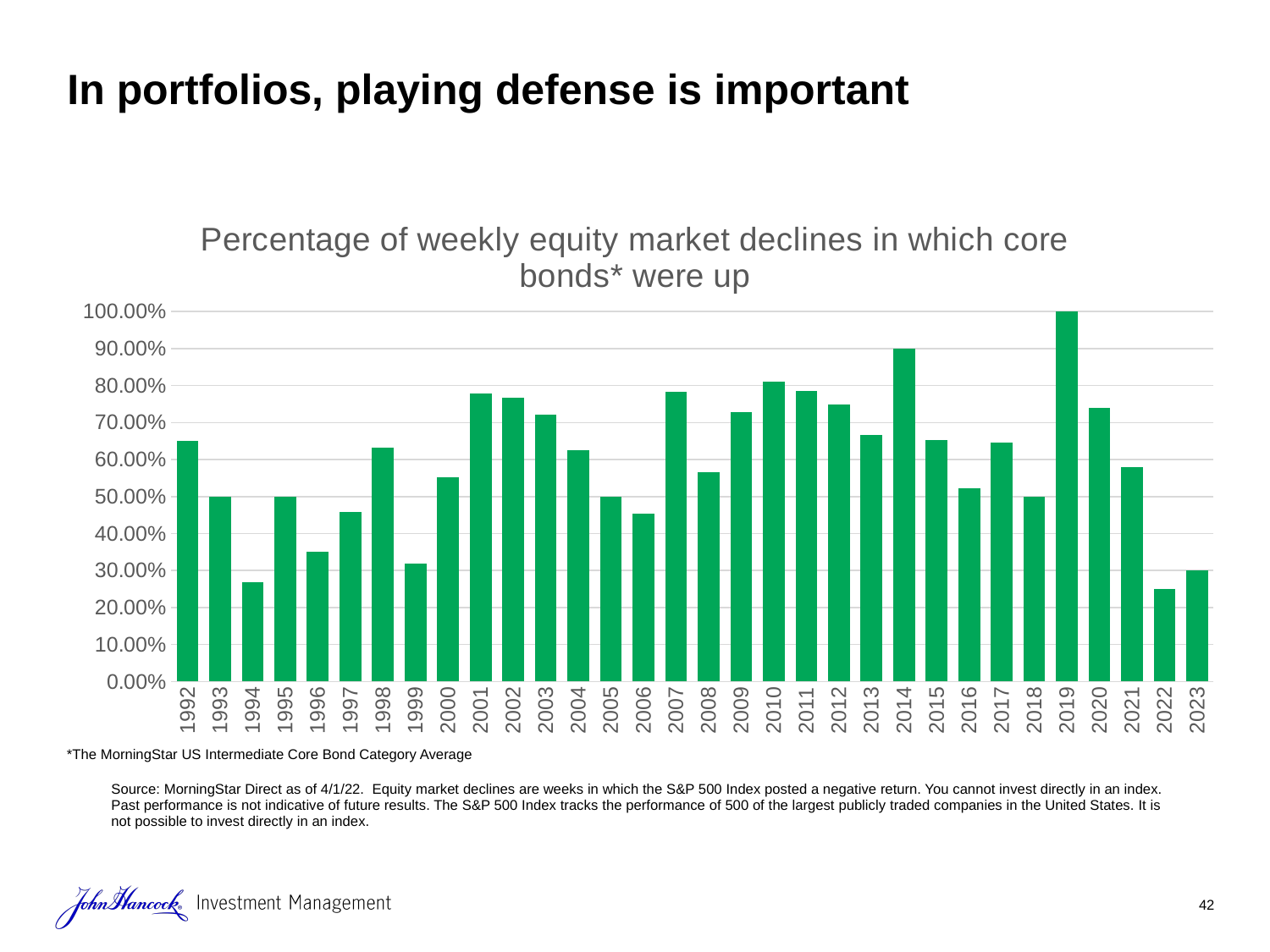
Which year has the highest percentage of weekly equity market declines in which core bonds were up? 2019 What is the value for 2018? 50.00% Is the value for 1999 greater or less than 40.00%? less Which is larger, the value for 1992 or the value for 1994? 1992 Which is larger, the value for 2014 or the value for 2020? 2014 How many years are shown on the x axis? 32 What is the title of the chart? Percentage of weekly equity market declines in which core bonds* were up Is the value for 2022 greater or less than 30.00%? less What is the value for 2019? 100.00% Is the value for 2020 greater or less than 70.00%? greater What kind of chart is shown on the slide? bar chart What is the value for 2014? 90.00%